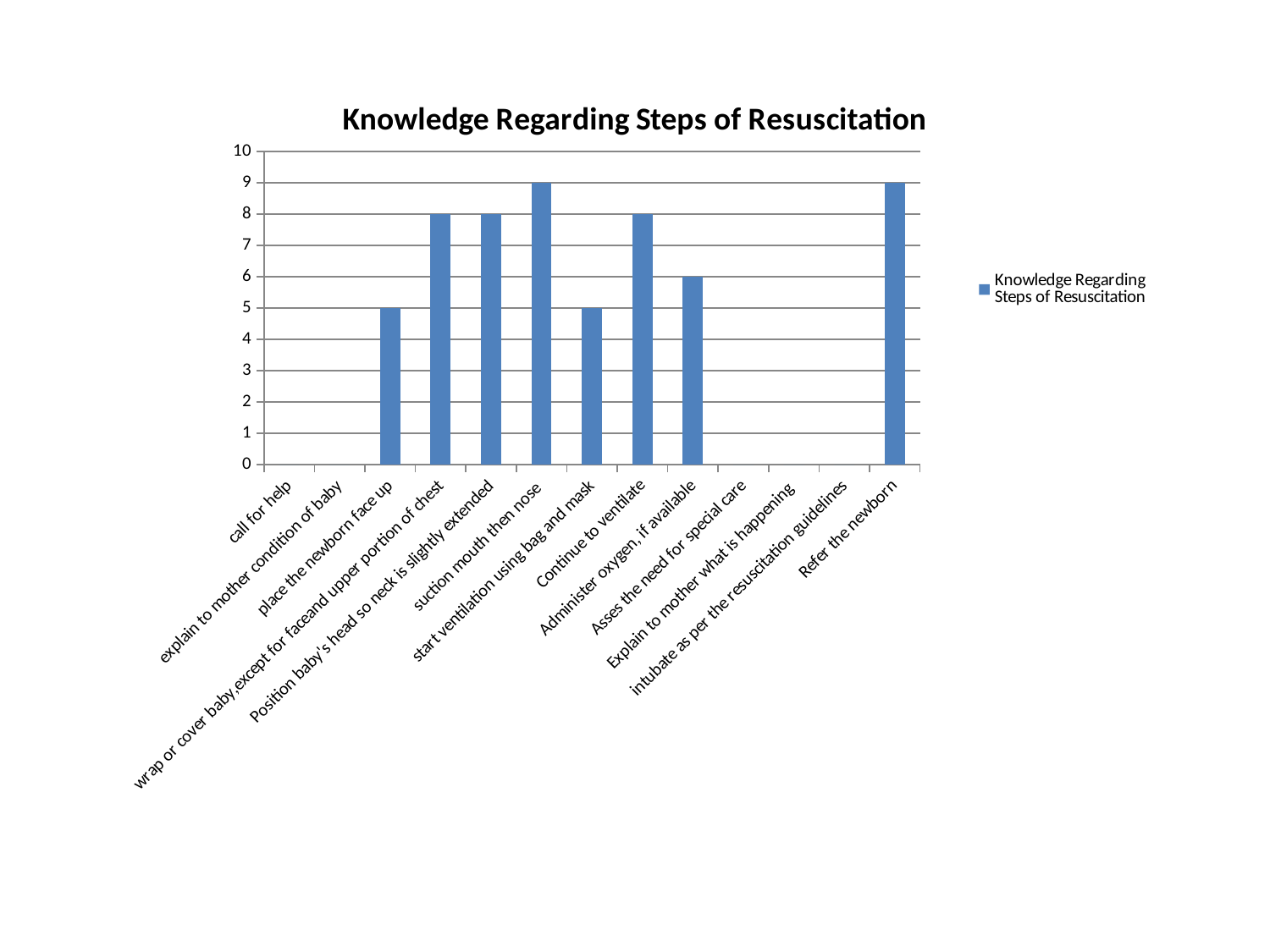
What is the value for 'Administer oxygen, if available'? 6 What is the value for 'place the newborn face up'? 5 How many series does the legend list? 1 What is the value for 'Continue to ventilate'? 8 What is the value for 'suction mouth then nose'? 9 What is the title of the chart? Knowledge Regarding Steps of Resuscitation What is the difference between the values for 'Refer the newborn' and 'start ventilation using bag and mask'? 4 Is the value for 'wrap or cover baby,except for faceand upper portion of chest' greater or less than 5? greater What type of chart is shown on the slide? bar chart Which has a larger value, 'Position baby's head so neck is slightly extended' or 'Administer oxygen, if available'? Position baby's head so neck is slightly extended What is the highest value reached by any bar in the chart? 9 How many categories are shown on the x axis? 13